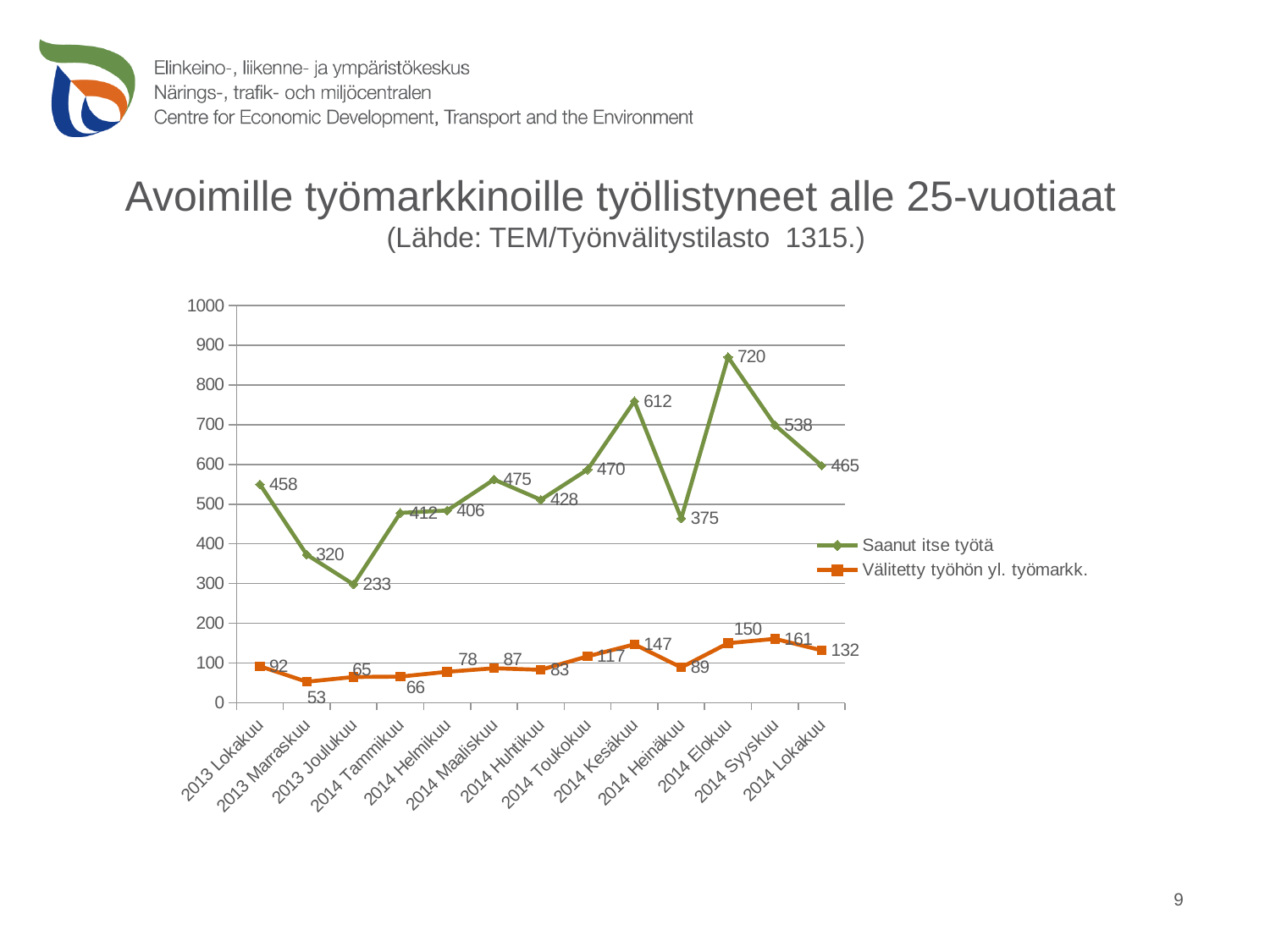
What is the value of Saanut itse työtä for 2014 Elokuu? 720 In which month is Saanut itse työtä lowest? 2013 Joulukuu How many series does the legend list? 2 Does Saanut itse työtä rise or fall from 2014 Elokuu to 2014 Lokakuu? fall What is the source cited in the chart subtitle? TEM/Työnvälitystilasto 1315. In which month is Saanut itse työtä highest? 2014 Elokuu What is the difference between Saanut itse työtä and Välitetty työhön yl. työmarkk. in 2014 Kesäkuu? 465 How many months are plotted along the x axis? 13 What kind of chart is shown on the slide? line chart Which is larger for Saanut itse työtä: 2014 Kesäkuu or 2014 Heinäkuu? 2014 Kesäkuu What is the value of Välitetty työhön yl. työmarkk. for 2013 Marraskuu? 53 In which month is Välitetty työhön yl. työmarkk. highest? 2014 Syyskuu